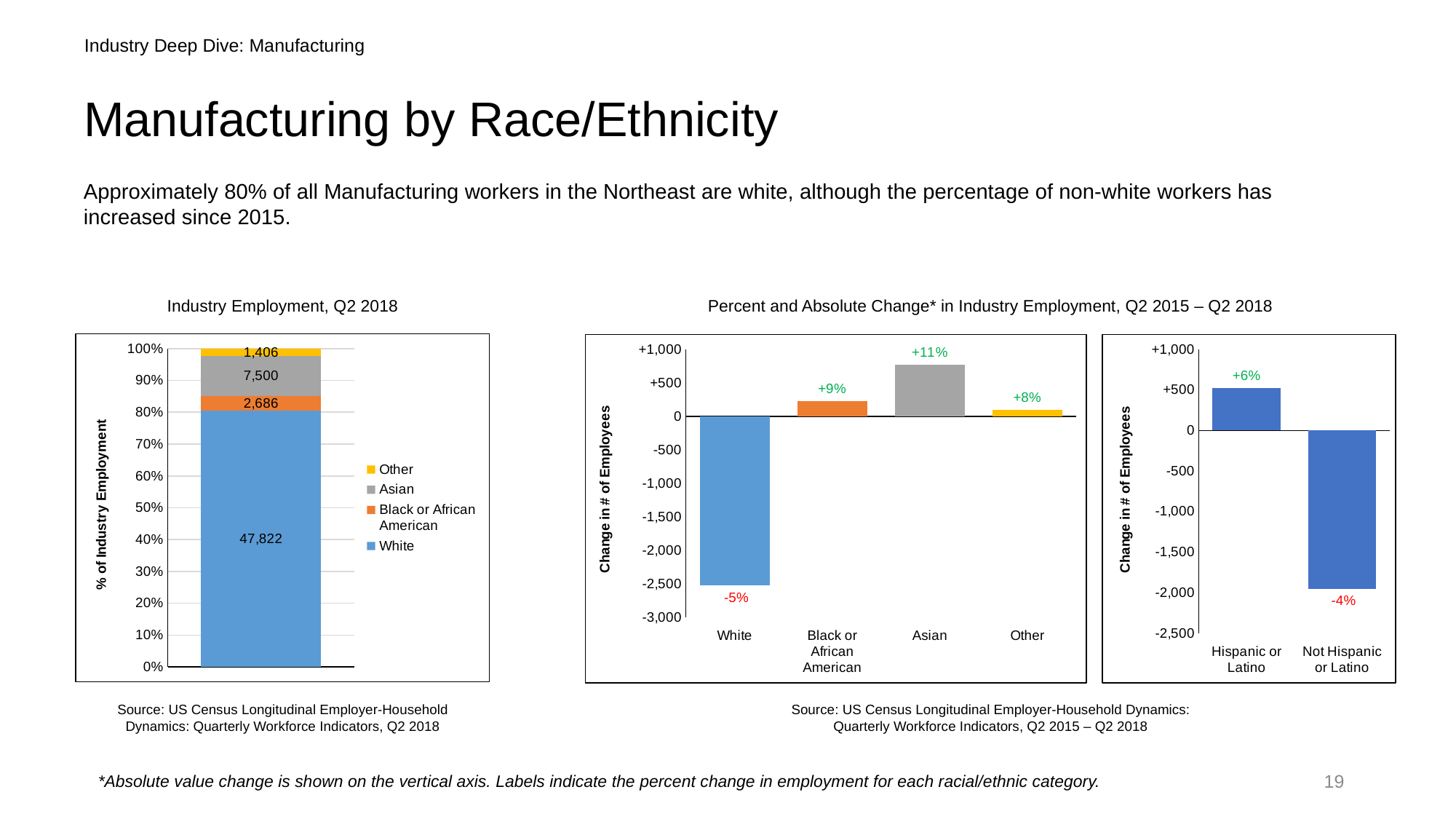
In the middle chart (Percent and Absolute Change in Industry Employment by race), is the change in number of employees for Asian greater or less than 500? greater In the Industry Employment, Q2 2018 chart, what is the difference between the Asian and Other values? 6,094 In the Industry Employment, Q2 2018 chart, how many series does the legend list? 4 In the Industry Employment, Q2 2018 chart, what is the total of the stacked bar? 59,414 In the middle chart (Percent and Absolute Change in Industry Employment by race), what percent change label is shown for Asian? +11% In the Industry Employment, Q2 2018 chart, what is the value for Asian? 7,500 What kind of chart is the rightmost chart (Hispanic or Latino vs Not Hispanic or Latino)? bar chart In the Industry Employment, Q2 2018 chart, what is the value for White? 47,822 In the middle chart (Percent and Absolute Change in Industry Employment by race), which category has the lowest percent change label? White In the rightmost chart (change in employment for Hispanic or Latino vs Not Hispanic or Latino), what percent change label is shown for Not Hispanic or Latino? -4% In the middle chart (Percent and Absolute Change in Industry Employment by race), is the change in number of employees for White greater or less than -2,000? less In the Industry Employment, Q2 2018 chart, what is the value for Black or African American? 2,686